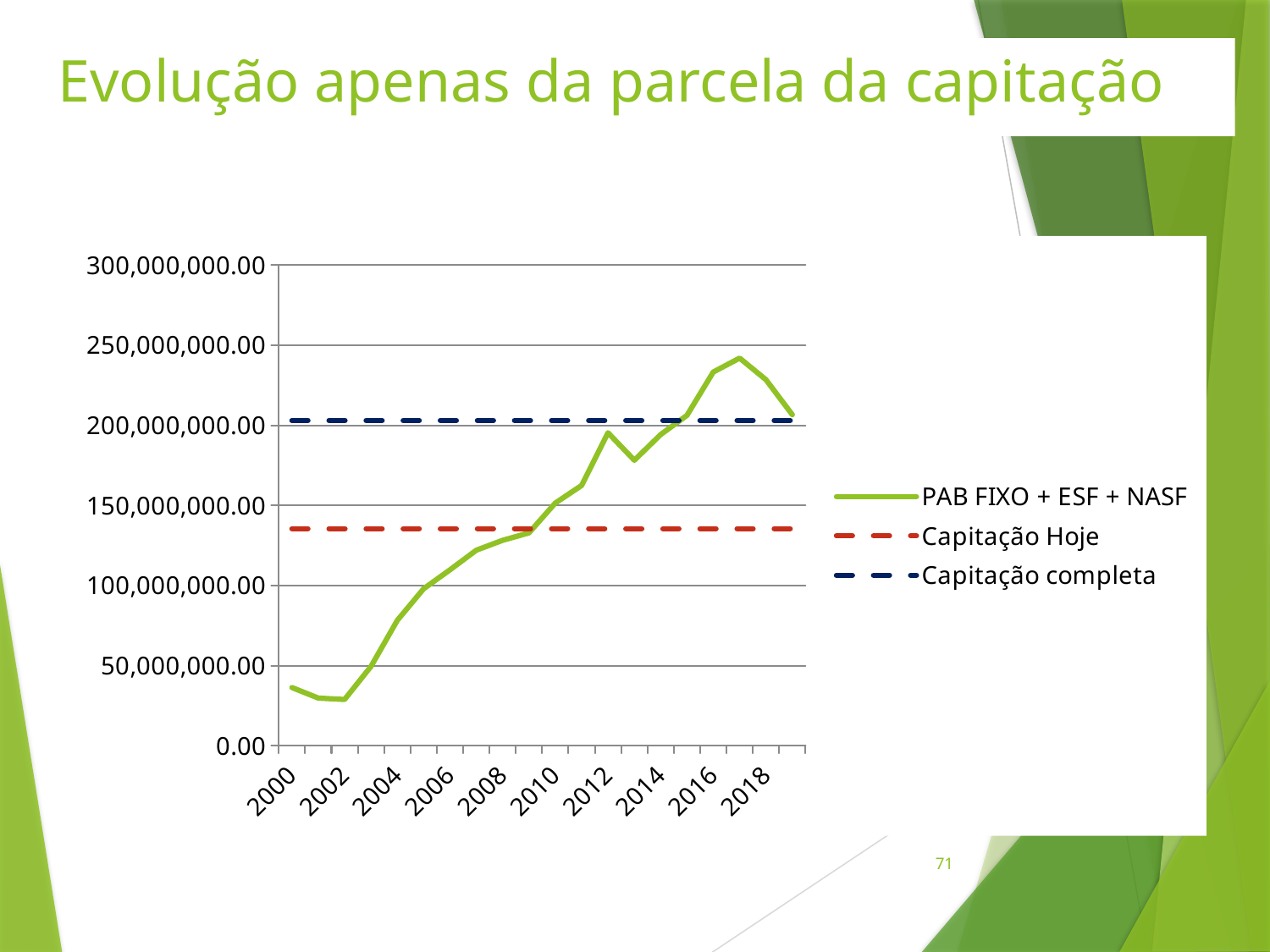
Is the value of PAB FIXO + ESF + NASF in 2000 greater or less than 50,000,000.00? less Is the Capitação Hoje line greater or less than 150,000,000.00? less How many series does the legend list? 3 Is the value of PAB FIXO + ESF + NASF in 2004 greater or less than 100,000,000.00? less Which is higher, the Capitação completa line or the Capitação Hoje line? Capitação completa Which series is drawn as a solid green line? PAB FIXO + ESF + NASF What kind of chart is shown on the slide? line chart Does the PAB FIXO + ESF + NASF series rise or fall between 2017 and 2019? fall What is the title of the slide containing the chart? Evolução apenas da parcela da capitação In which year does the PAB FIXO + ESF + NASF series reach its highest value? 2017 Does the PAB FIXO + ESF + NASF series rise or fall between 2002 and 2012? rise